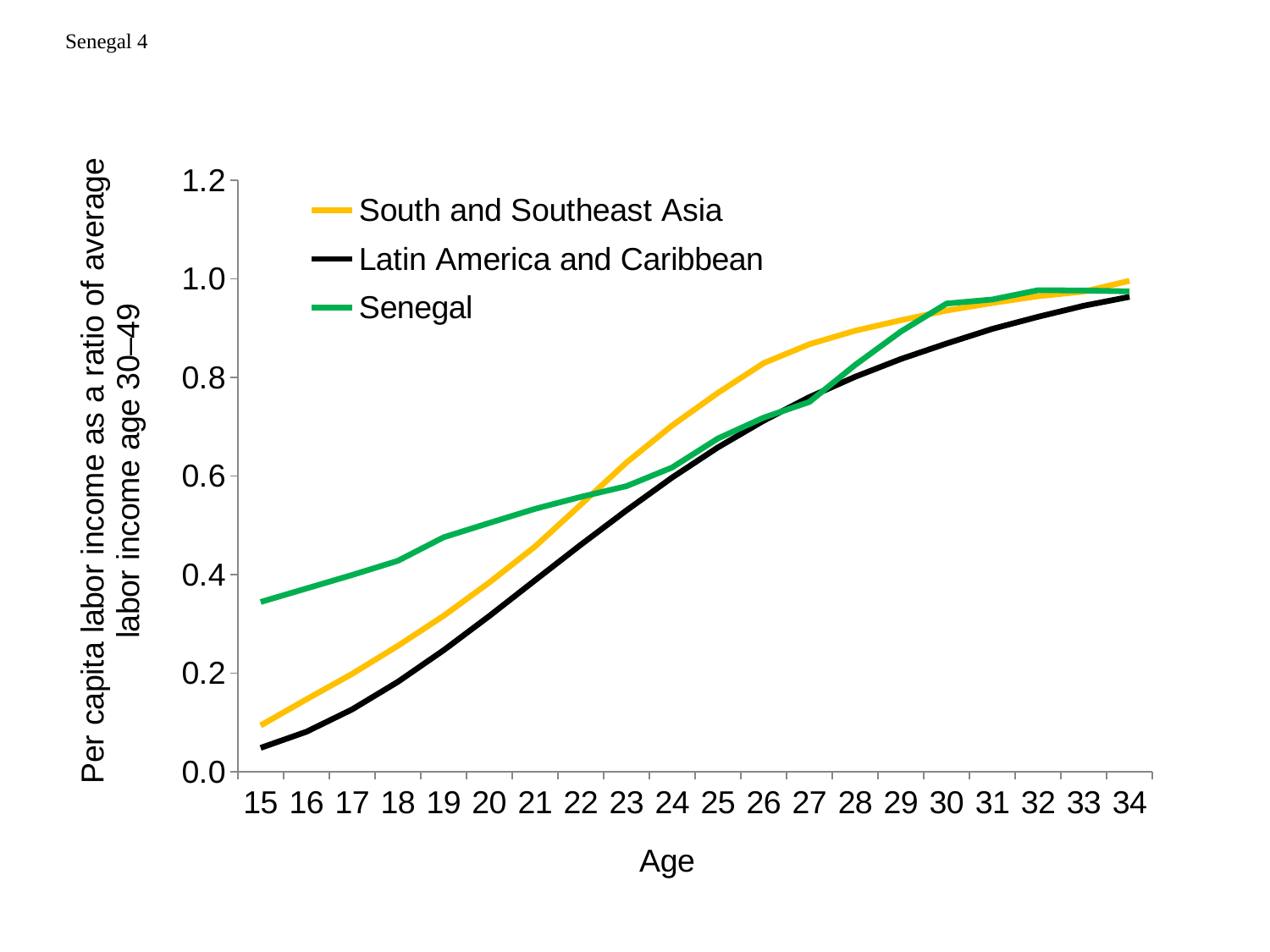
At age 15, which series has the lowest value? Latin America and Caribbean Is the value for South and Southeast Asia at age 27 greater or less than 0.8? greater Does the Senegal line rise or fall as age increases from 15 to 34? rise Is the value for Latin America and Caribbean at age 15 greater or less than 0.2? less At age 20, which is higher: Senegal or Latin America and Caribbean? Senegal Is the value for Senegal at age 15 greater or less than 0.2? greater How many age values are shown along the x axis? 20 What is the title of the x axis? Age What colour is the Senegal line? green How many series does the legend list? 3 What kind of chart is shown on the slide? line chart